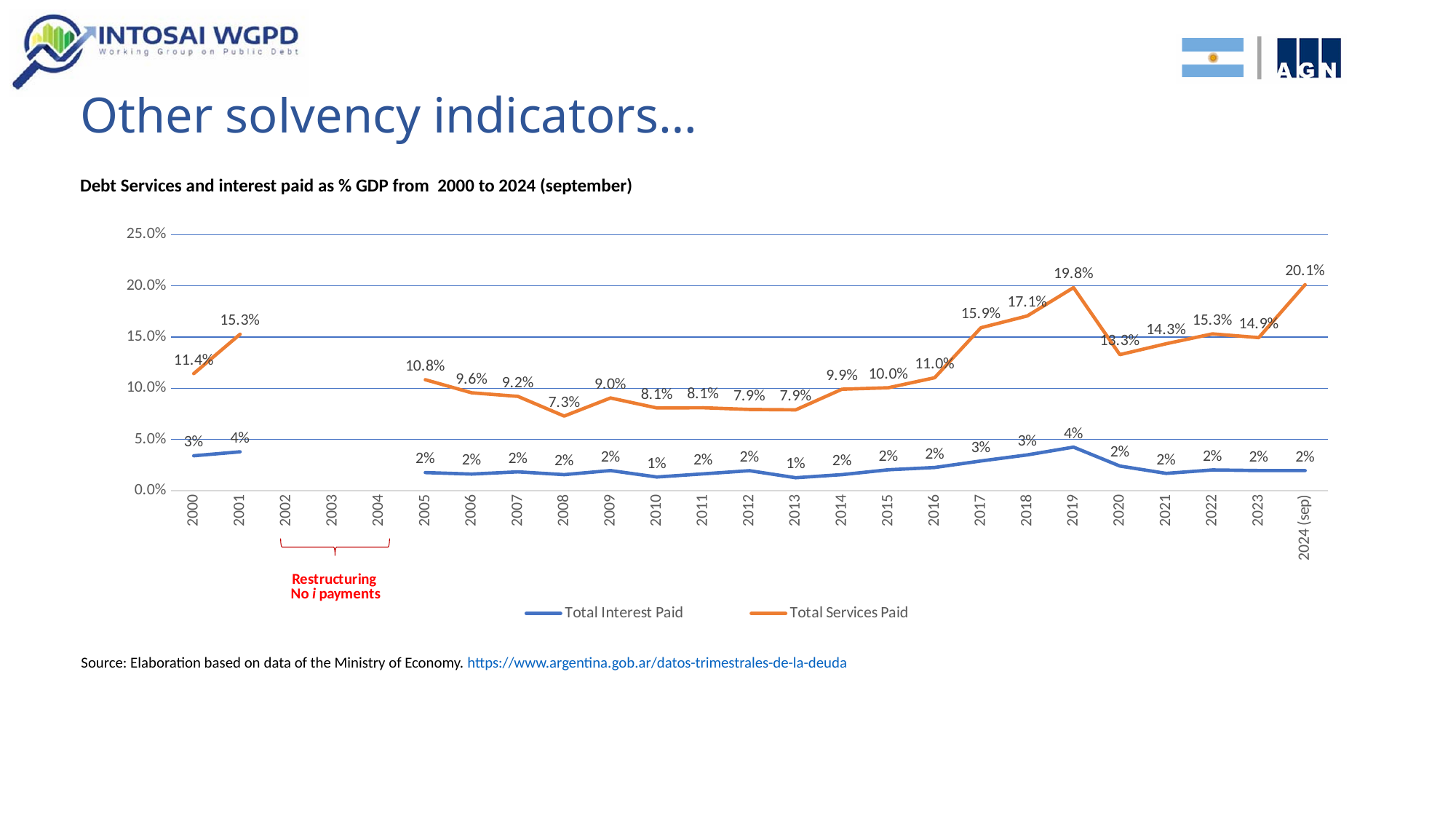
Does Total Services Paid rise or fall from 2016 to 2019? Rise In which year does Total Services Paid reach its highest value? 2024 (sep) Is the Total Services Paid value for 2018 greater or less than 15.0%? greater What is the Total Services Paid value for 2024 (sep)? 20.1% What kind of chart is shown on the slide? Line chart How many series does the legend list? 2 What is the Total Services Paid value for 2008? 7.3% In which year is Total Services Paid at its lowest? 2008 What is the Total Interest Paid value for 2001? 4% Which is larger, Total Services Paid in 2001 or in 2017? 2017 What is the difference between Total Services Paid in 2019 and in 2020? 6.5% What is the Total Services Paid value for 2019? 19.8%